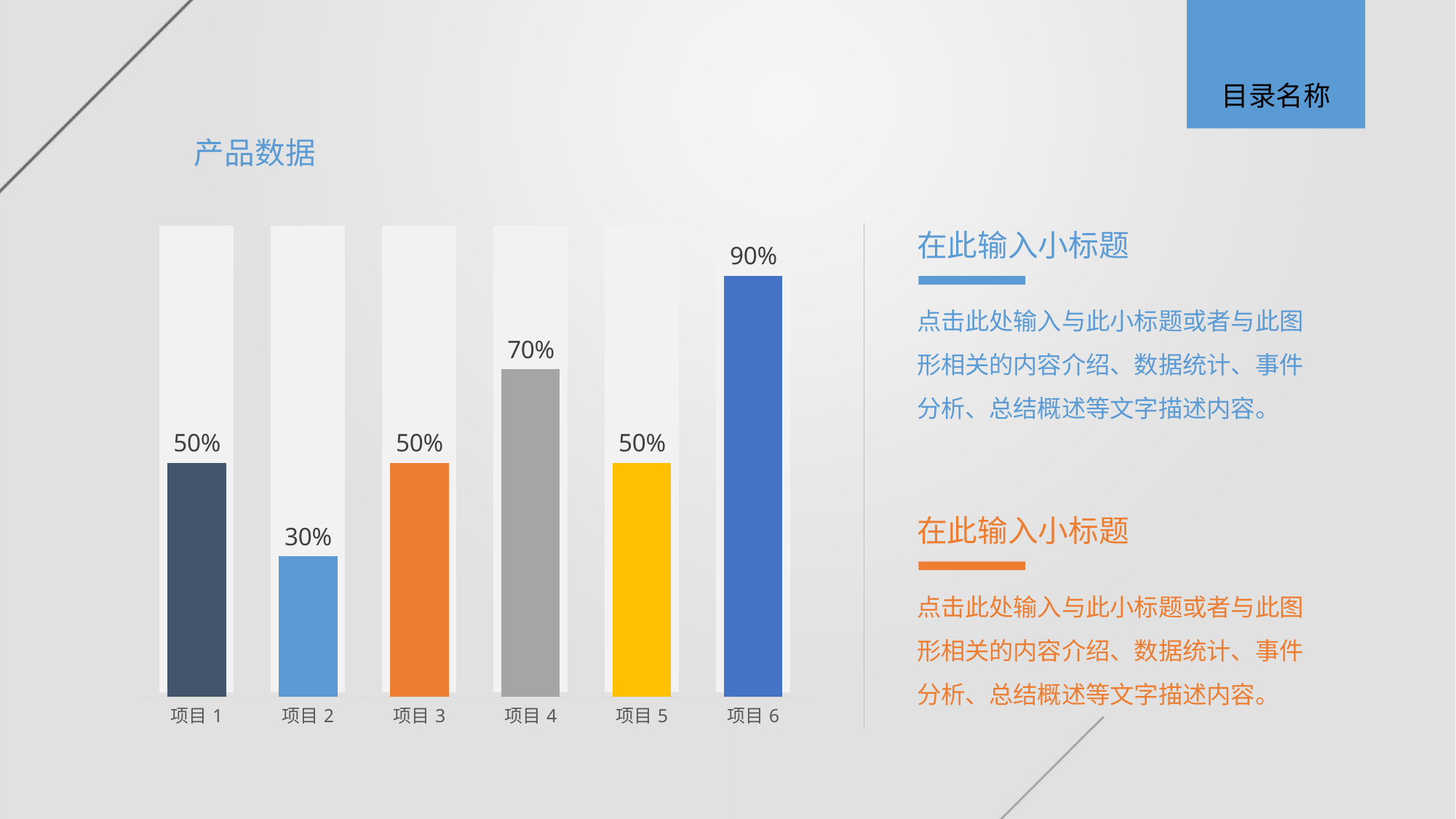
Which category has the highest value? 项目 6 What is the title of the chart? 产品数据 What is the value for 项目 1? 50% Which is larger, the value for 项目 4 or the value for 项目 5? 项目 4 How many categories are shown in the chart? 6 What is the value for 项目 4? 70% Which category has the lowest value? 项目 2 What kind of chart is shown on the slide? bar chart What is the difference between the values for 项目 6 and 项目 2? 60% What is the value for 项目 6? 90% What is the value for 项目 2? 30% What is the difference between the values for 项目 4 and 项目 3? 20%